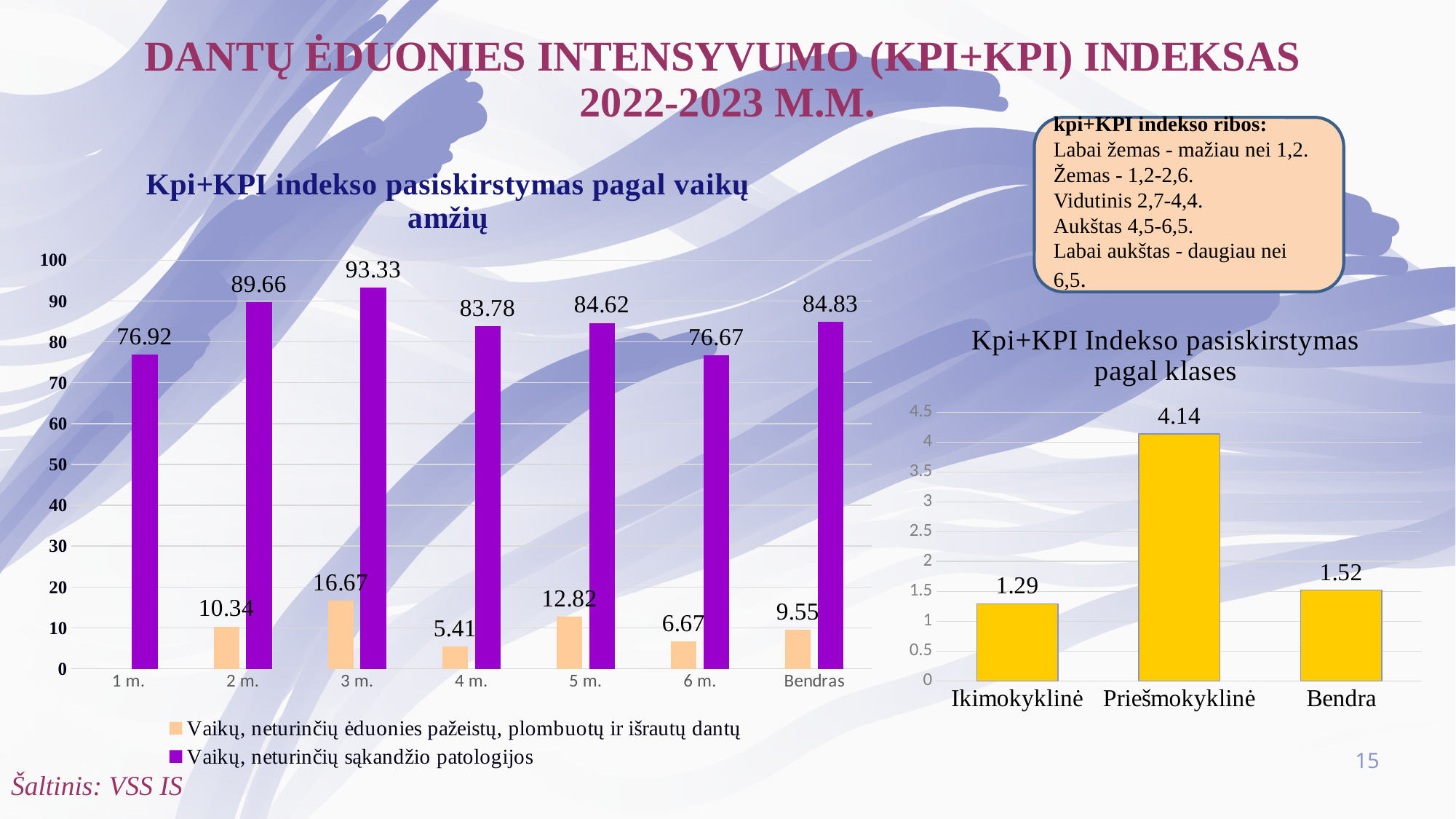
In the chart 'Kpi+KPI Indekso pasiskirstymas pagal klases', what is the value for Priešmokyklinė? 4.14 In the chart 'Kpi+KPI Indekso pasiskirstymas pagal klases', what is the difference between the values for Priešmokyklinė and Bendra? 2.62 In the chart 'Kpi+KPI indekso pasiskirstymas pagal vaikų amžių', which age group has the lowest value for 'Vaikų, neturinčių ėduonies pažeistų, plombuotų ir išrautų dantų' among those with a labelled bar? 4 m. In the chart 'Kpi+KPI indekso pasiskirstymas pagal vaikų amžių', how many series does the legend list? 2 In the chart 'Kpi+KPI indekso pasiskirstymas pagal vaikų amžių', how many categories are shown on the x axis? 7 In the chart 'Kpi+KPI indekso pasiskirstymas pagal vaikų amžių', what is the difference between the 'Vaikų, neturinčių sąkandžio patologijos' values for 2 m. and 1 m.? 12.74 In the chart 'Kpi+KPI indekso pasiskirstymas pagal vaikų amžių', which age group has the highest value for 'Vaikų, neturinčių sąkandžio patologijos'? 3 m. In the chart 'Kpi+KPI indekso pasiskirstymas pagal vaikų amžių', what is the value for 'Vaikų, neturinčių ėduonies pažeistų, plombuotų ir išrautų dantų' at 5 m.? 12.82 In the chart 'Kpi+KPI indekso pasiskirstymas pagal vaikų amžių', what is the value for 'Vaikų, neturinčių sąkandžio patologijos' at 3 m.? 93.33 What kind of chart is 'Kpi+KPI Indekso pasiskirstymas pagal klases'? Bar chart In the chart 'Kpi+KPI indekso pasiskirstymas pagal vaikų amžių', is the 'Vaikų, neturinčių sąkandžio patologijos' value for 4 m. or for 5 m. larger? 5 m. In the chart 'Kpi+KPI Indekso pasiskirstymas pagal klases', which category has the lowest value? Ikimokyklinė